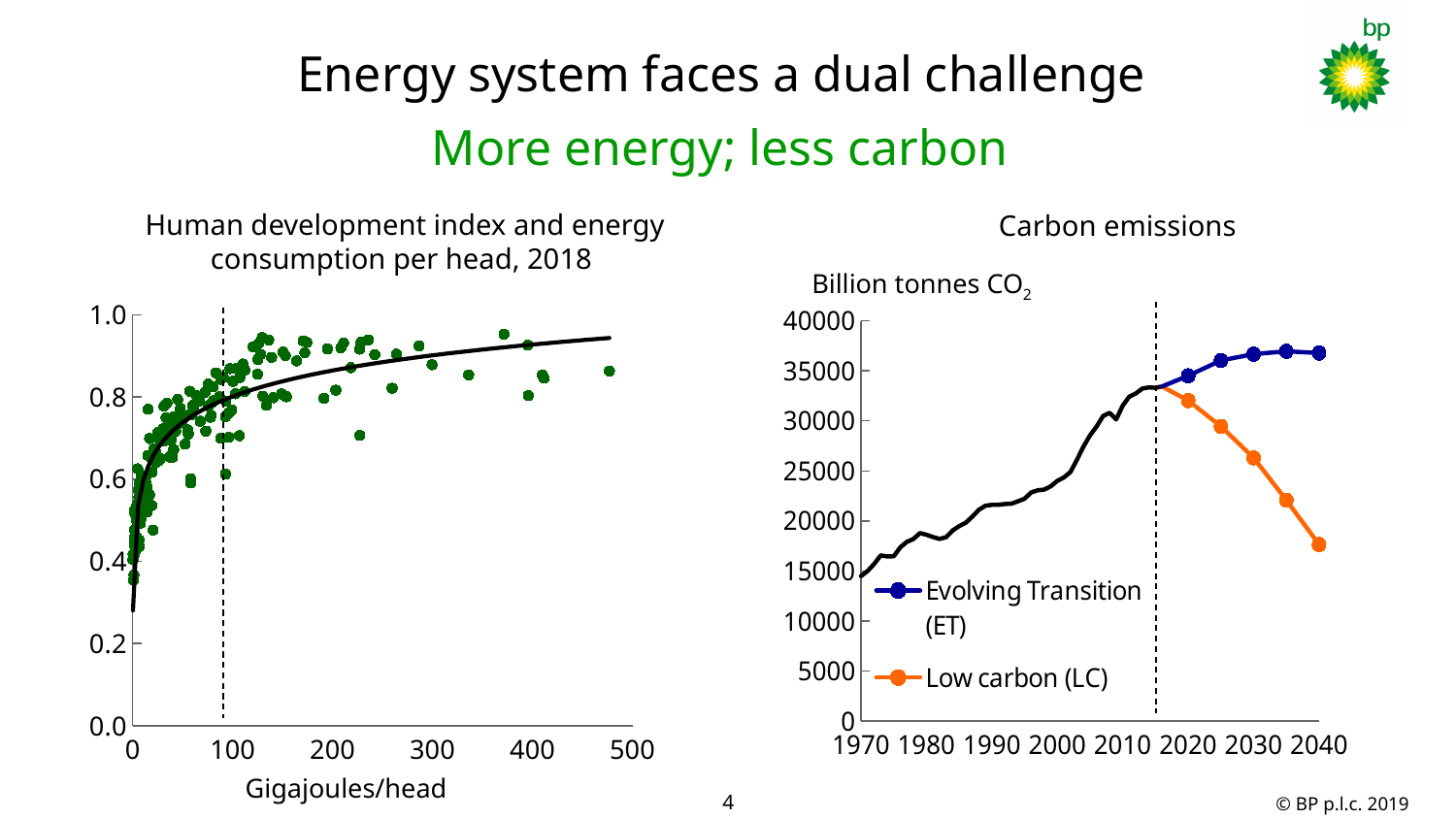
On the Carbon emissions chart, which series has the higher value in 2040, Evolving Transition (ET) or Low carbon (LC)? Evolving Transition (ET) On the Carbon emissions chart, is the Evolving Transition (ET) value in 2040 greater or less than 35000? greater What is the x-axis label of the Human development index and energy consumption per head, 2018 chart? Gigajoules/head On the Carbon emissions chart, how many series does the legend list? 2 On the Carbon emissions chart, does the Evolving Transition (ET) series rise or fall between 2020 and 2040? rise What kind of chart is the Human development index and energy consumption per head, 2018 chart? scatter chart What kind of chart is the Carbon emissions chart? line chart On the Carbon emissions chart, is the Low carbon (LC) value in 2030 greater or less than 30000? less On the Carbon emissions chart, is the value in 1970 greater or less than 20000? less On the Carbon emissions chart, does the Low carbon (LC) series rise or fall between 2020 and 2040? fall On the Carbon emissions chart, what are the two series named in the legend? Evolving Transition (ET) and Low carbon (LC)